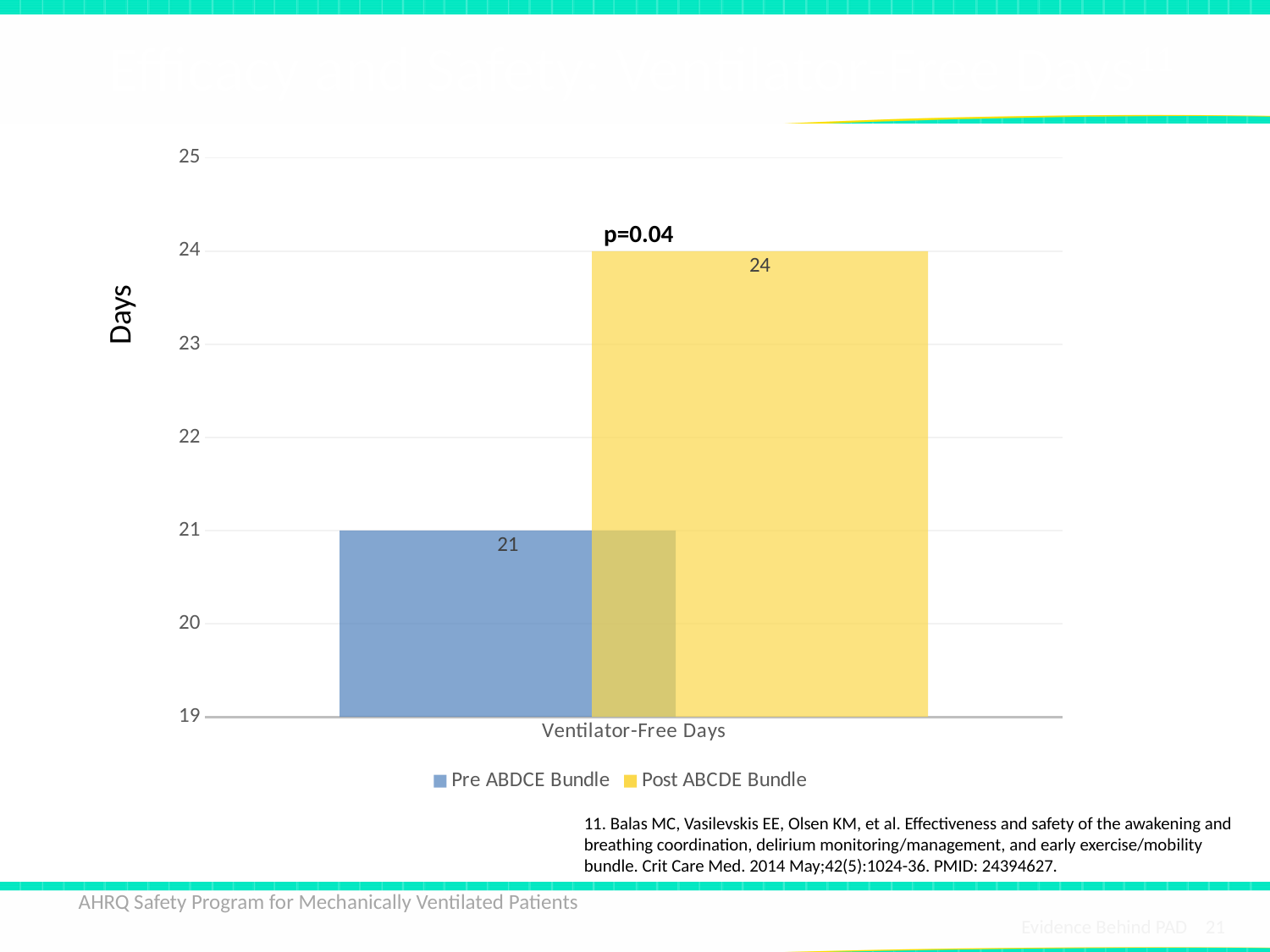
How many categories are shown on the x axis? 1 Which series has the higher value for Ventilator-Free Days? Post ABCDE Bundle Which series has the lower value for Ventilator-Free Days? Pre ABDCE Bundle What is the label of the y axis? Days Is the value for Post ABCDE Bundle greater or less than 22? greater What is the value for Post ABCDE Bundle for Ventilator-Free Days? 24 What is the value for Pre ABDCE Bundle for Ventilator-Free Days? 21 How many series does the legend list? 2 What is the difference between the Post ABCDE Bundle and Pre ABDCE Bundle values for Ventilator-Free Days? 3 What kind of chart is shown on the slide? bar chart What p-value is printed above the bars? p=0.04 Is the value for Pre ABDCE Bundle larger or smaller than the value for Post ABCDE Bundle? smaller